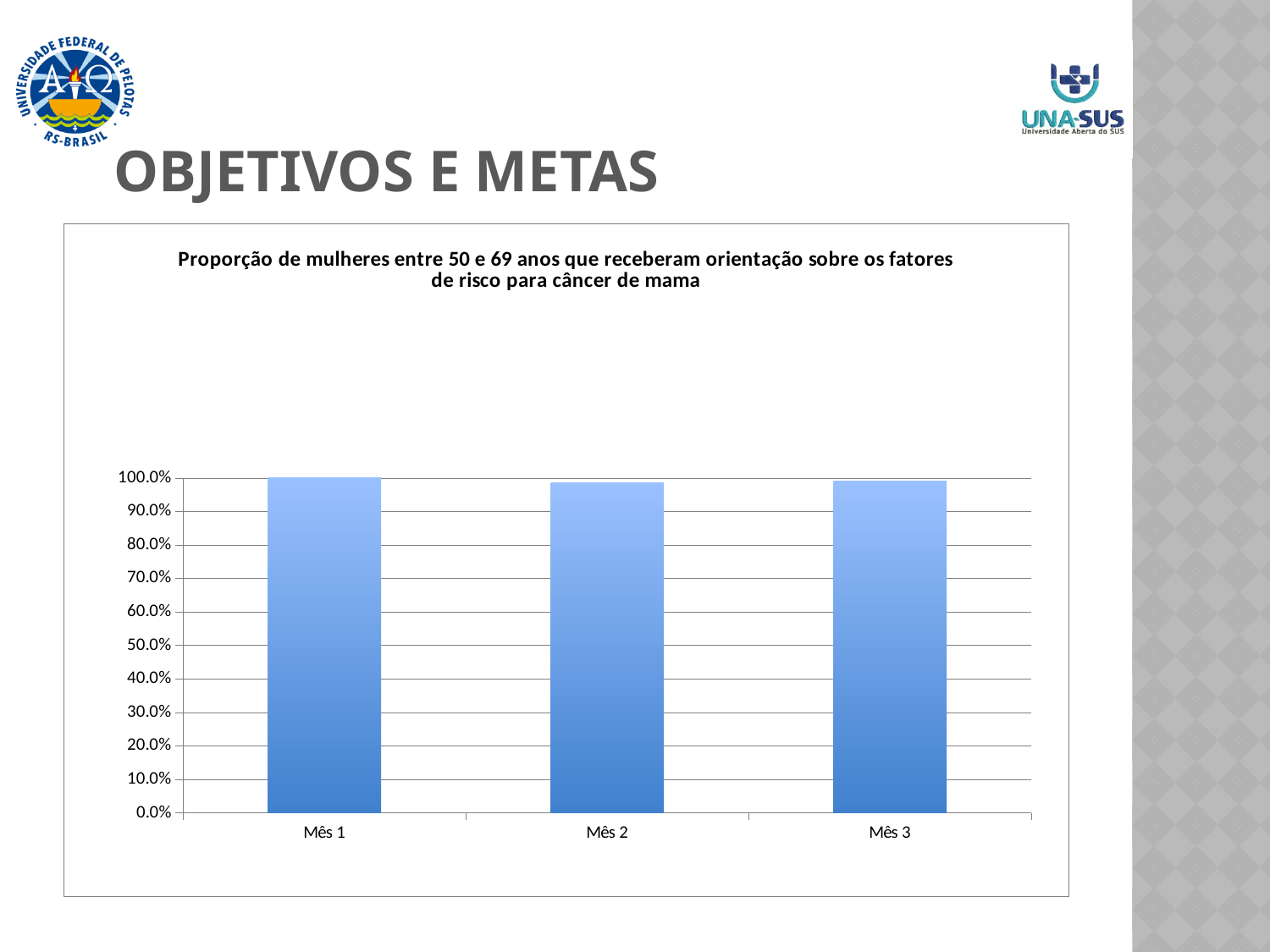
What is the value for Mês 1? 100.0% Is the value for Mês 2 greater or less than 100.0%? less What is the highest tick value shown on the y axis? 100.0% How many months (categories) are plotted on the x axis? 3 Which month has the highest value? Mês 1 Is the value for Mês 2 greater or less than 90.0%? greater What is the label of the first category on the x axis? Mês 1 Is the value for Mês 3 greater or less than 90.0%? greater Which is larger, the value for Mês 1 or the value for Mês 2? Mês 1 What kind of chart is shown on the slide? bar chart